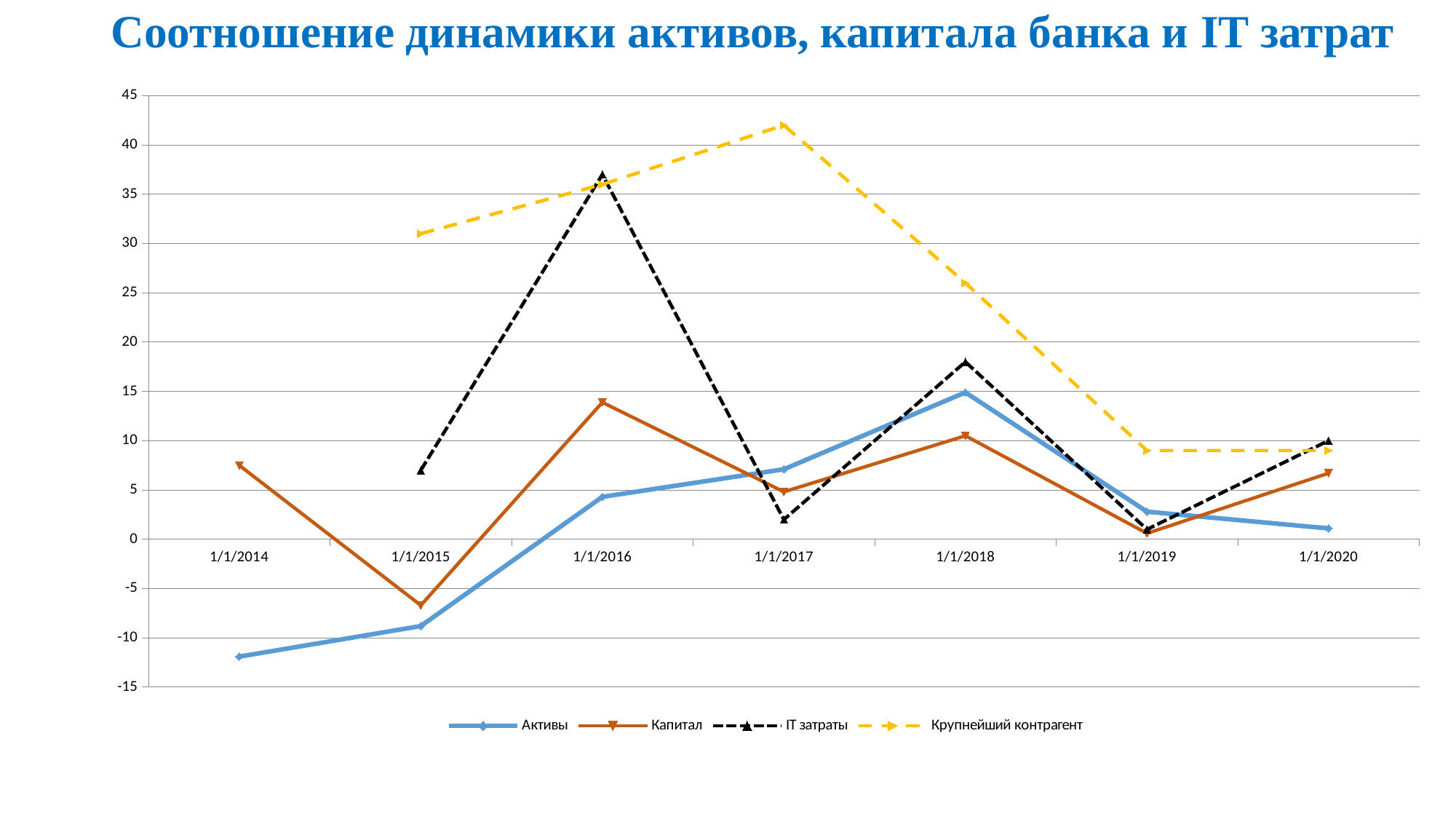
What kind of chart is shown on the slide? line chart Is the value for Активы at 1/1/2014 greater or less than -10? less At which date does the Активы series reach its lowest value? 1/1/2014 Is the value for IT затраты at 1/1/2016 greater or less than 35? greater How many dates are shown on the x axis? 7 How many series does the legend list? 4 At which date does the IT затраты series reach its highest value? 1/1/2016 At 1/1/2016, which is larger: Капитал or Активы? Капитал At which date does the Активы series reach its highest value? 1/1/2018 At which date does the Крупнейший контрагент series reach its highest value? 1/1/2017 What is the title of the chart? Соотношение динамики активов, капитала банка и IT затрат Does the Крупнейший контрагент series rise or fall from 1/1/2017 to 1/1/2019? fall